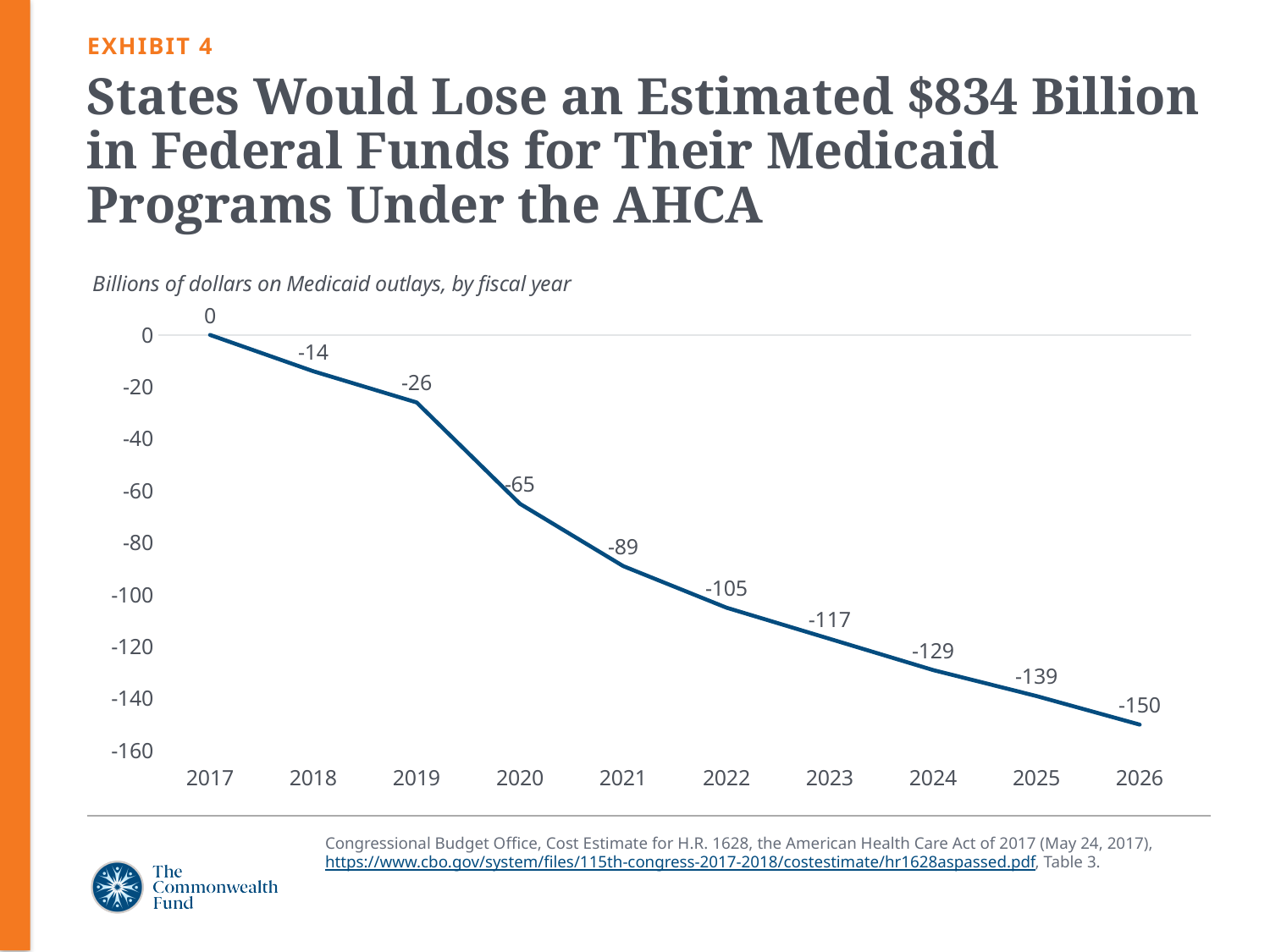
Which year has the highest value? 2017 Do the values rise or fall from 2017 to 2026? fall What is the value for 2024? -129 What is the subtitle describing the units of the chart? Billions of dollars on Medicaid outlays, by fiscal year What is the value for 2018? -14 What is the difference between the values for 2026 and 2025? 11 How many years are plotted on the chart? 10 Which is larger, the value for 2021 or the value for 2023? 2021 What kind of chart is shown? line chart What is the value for 2020? -65 Which year has the lowest value? 2026 What is the difference between the values for 2019 and 2020? 39